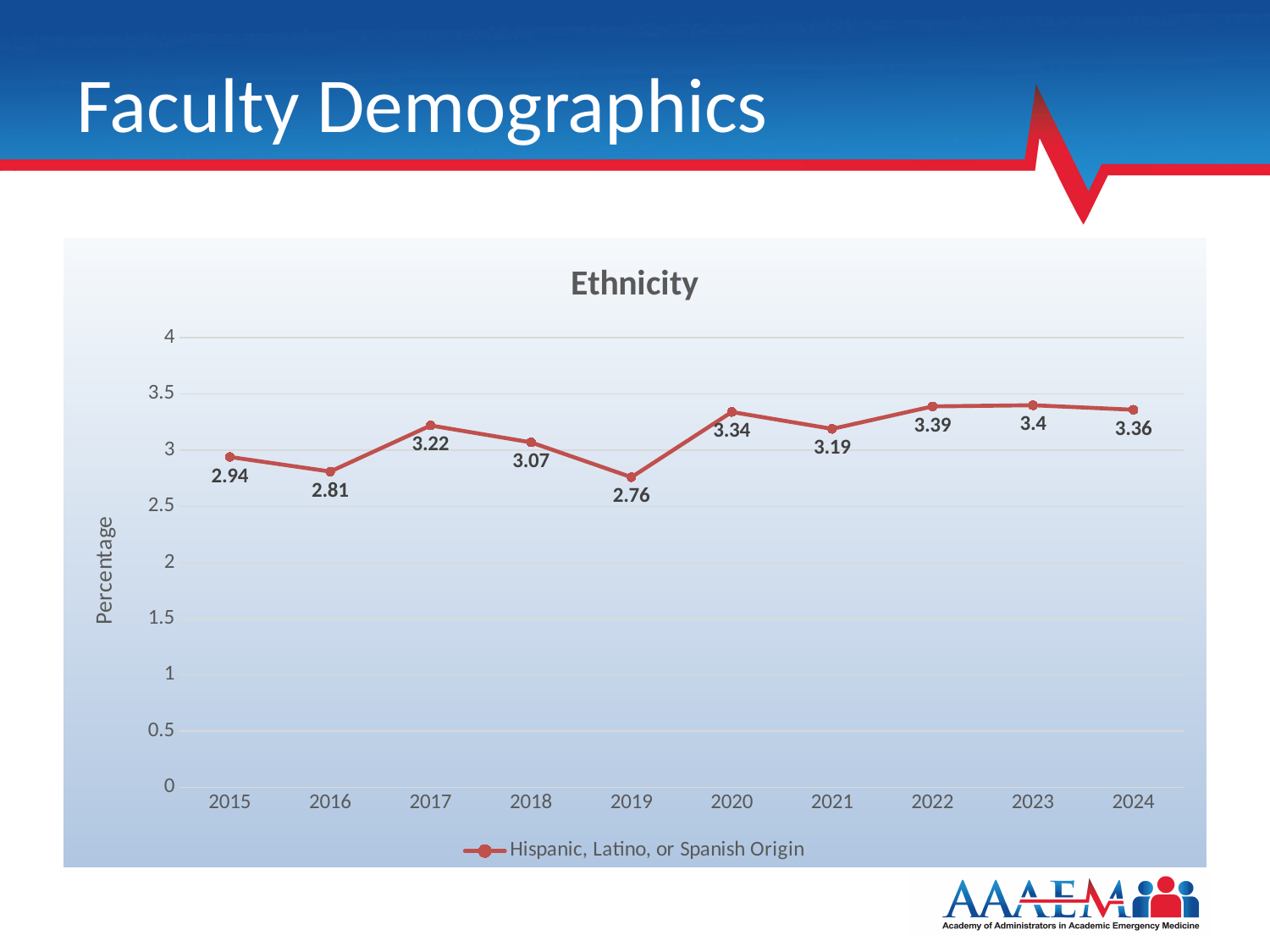
Which year has the highest value? 2023 What is the value for 2019? 2.76 What is the value for 2023? 3.4 Which is larger, the value for 2017 or the value for 2021? 2017 Is the value for 2016 greater or less than 3? less What is the value for 2015? 2.94 What kind of chart is shown? line chart How many series does the legend list? 1 What is the title of the chart? Ethnicity How many years are plotted on the x axis? 10 What is the difference between the values for 2024 and 2015? 0.42 Which year has the lowest value? 2019